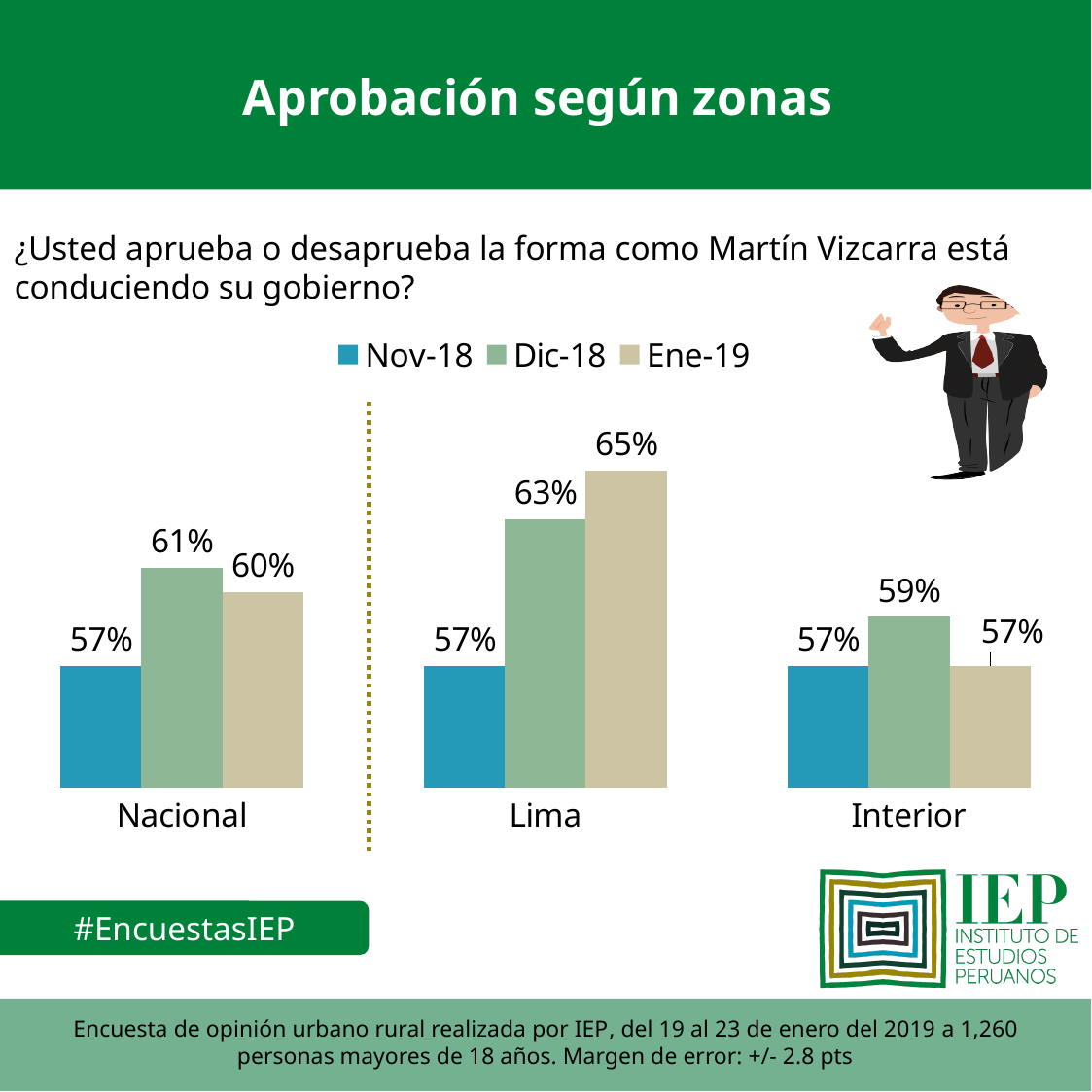
What is the Nov-18 approval value for Interior? 57% What is the title of the slide? Aprobación según zonas How many series does the legend list? 3 What is the Dic-18 approval value for Nacional? 61% Which zone has the highest Ene-19 approval value? Lima What is the Ene-19 approval value for Lima? 65% What is the difference between the Ene-19 and Nov-18 values for Lima? 8% What kind of chart is shown on the slide? Bar chart Which zone has the lowest Dic-18 approval value? Interior How many zones (categories) are shown on the chart? 3 Which is larger, the Ene-19 value for Nacional or the Ene-19 value for Interior? Nacional What is the difference between the Dic-18 and Ene-19 values for Interior? 2%